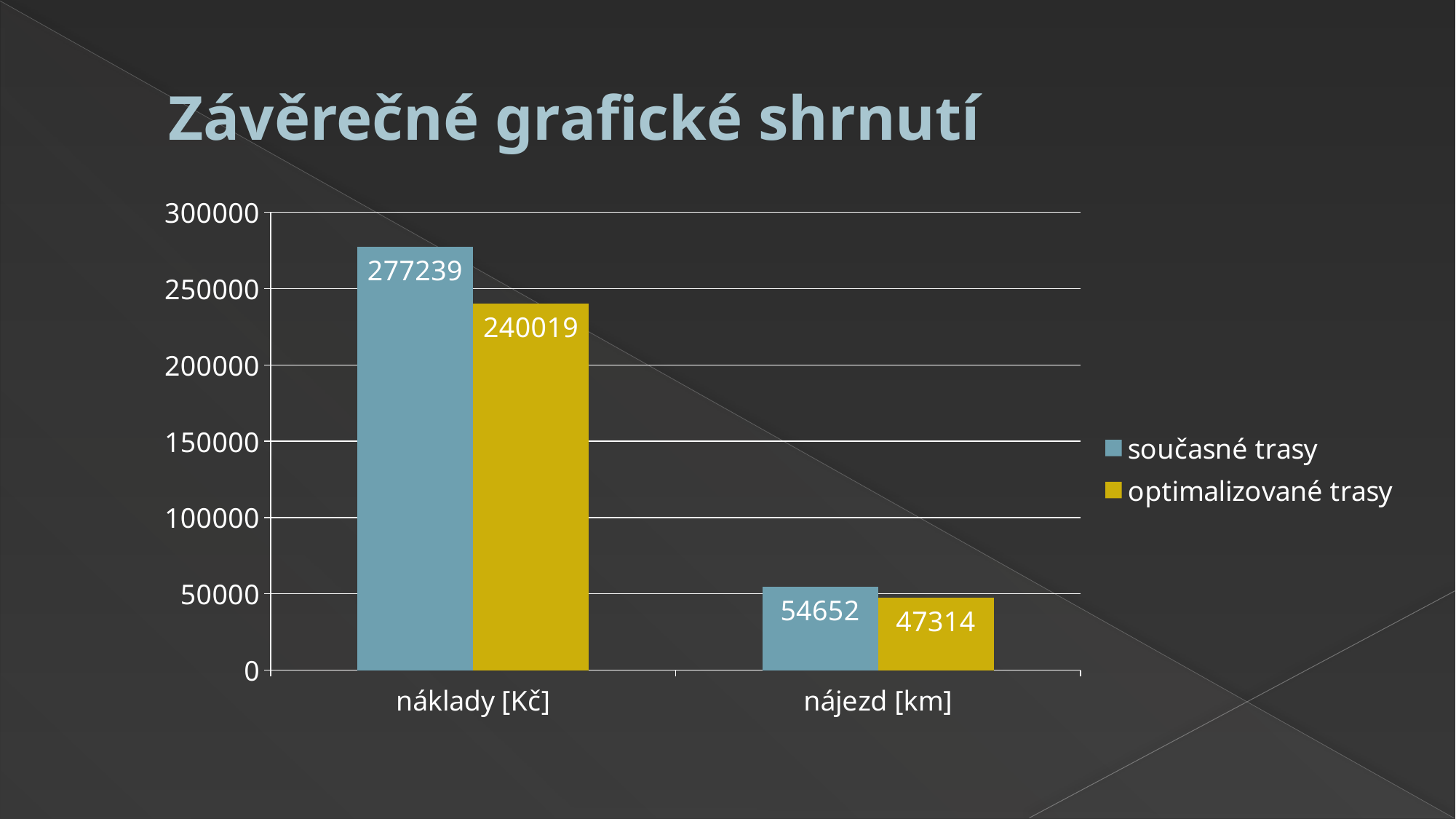
Which bar has the highest value on the chart? současné trasy, náklady [Kč] In the nájezd [km] category, which series has the larger value, současné trasy or optimalizované trasy? současné trasy What is the difference between současné trasy and optimalizované trasy in the náklady [Kč] category? 37220 What kind of chart is shown on the slide? bar chart How many series does the legend list? 2 What is the value for optimalizované trasy in the náklady [Kč] category? 240019 Which bar has the lowest value on the chart? optimalizované trasy, nájezd [km] What is the value for optimalizované trasy in the nájezd [km] category? 47314 What is the value for současné trasy in the náklady [Kč] category? 277239 How many categories are shown on the x axis? 2 What is the value for současné trasy in the nájezd [km] category? 54652 What is the difference between současné trasy and optimalizované trasy in the nájezd [km] category? 7338